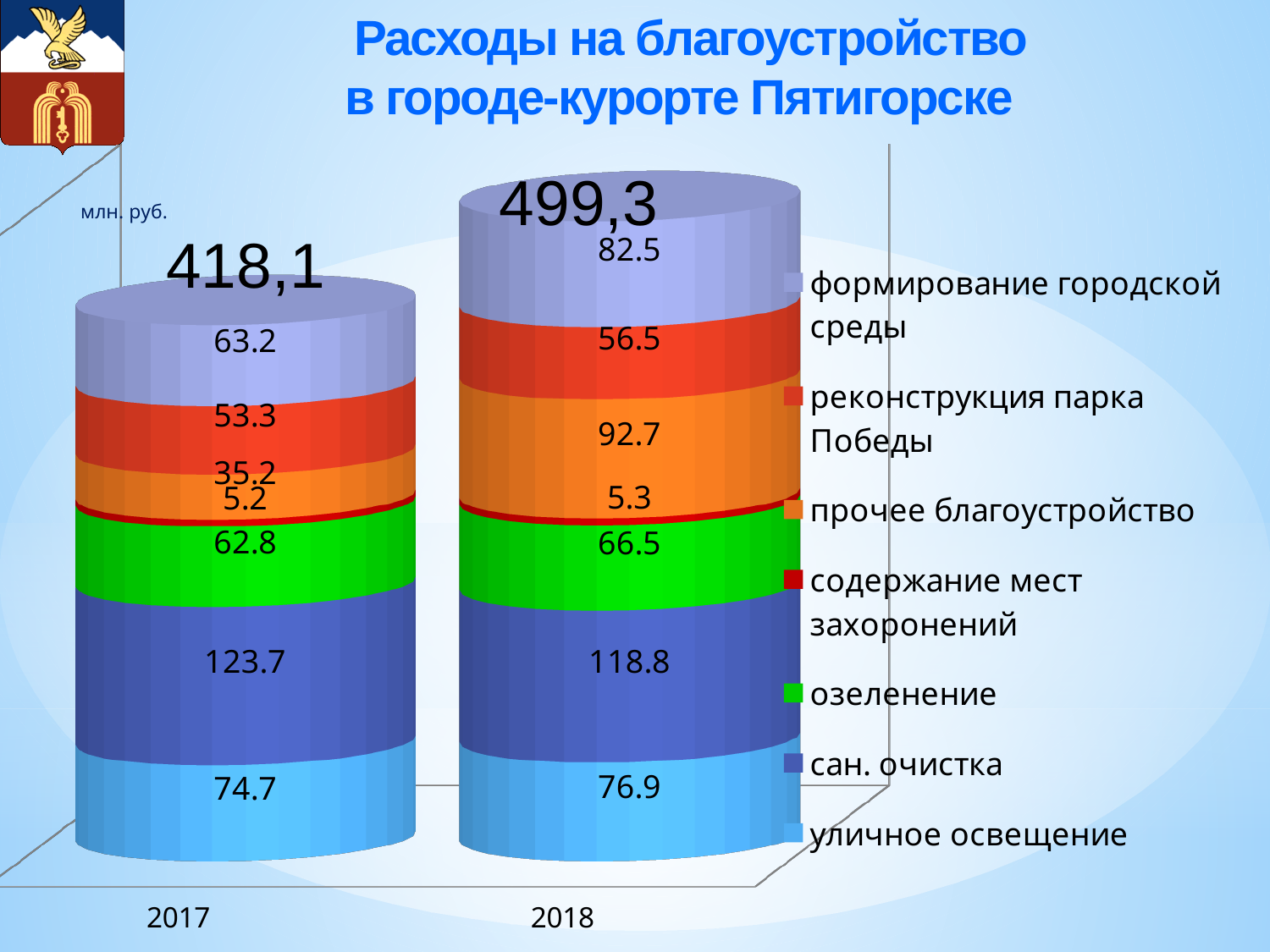
Which is larger: сан. очистка in 2017 or сан. очистка in 2018? 2017 What is the value for прочее благоустройство in 2018? 92.7 Which series has the largest value in the 2018 bar? сан. очистка What is the value for уличное освещение in 2018? 76.9 How many series does the legend list? 7 What is the total of the stacked bar for 2018? 499,3 What is the difference between the прочее благоустройство values for 2018 and 2017? 57.5 Which series has the smallest value in the 2017 bar? содержание мест захоронений What is the value for формирование городской среды in 2017? 63.2 What is the total of the stacked bar for 2017? 418,1 What is the value for сан. очистка in 2017? 123.7 What kind of chart is shown on the slide? stacked bar chart